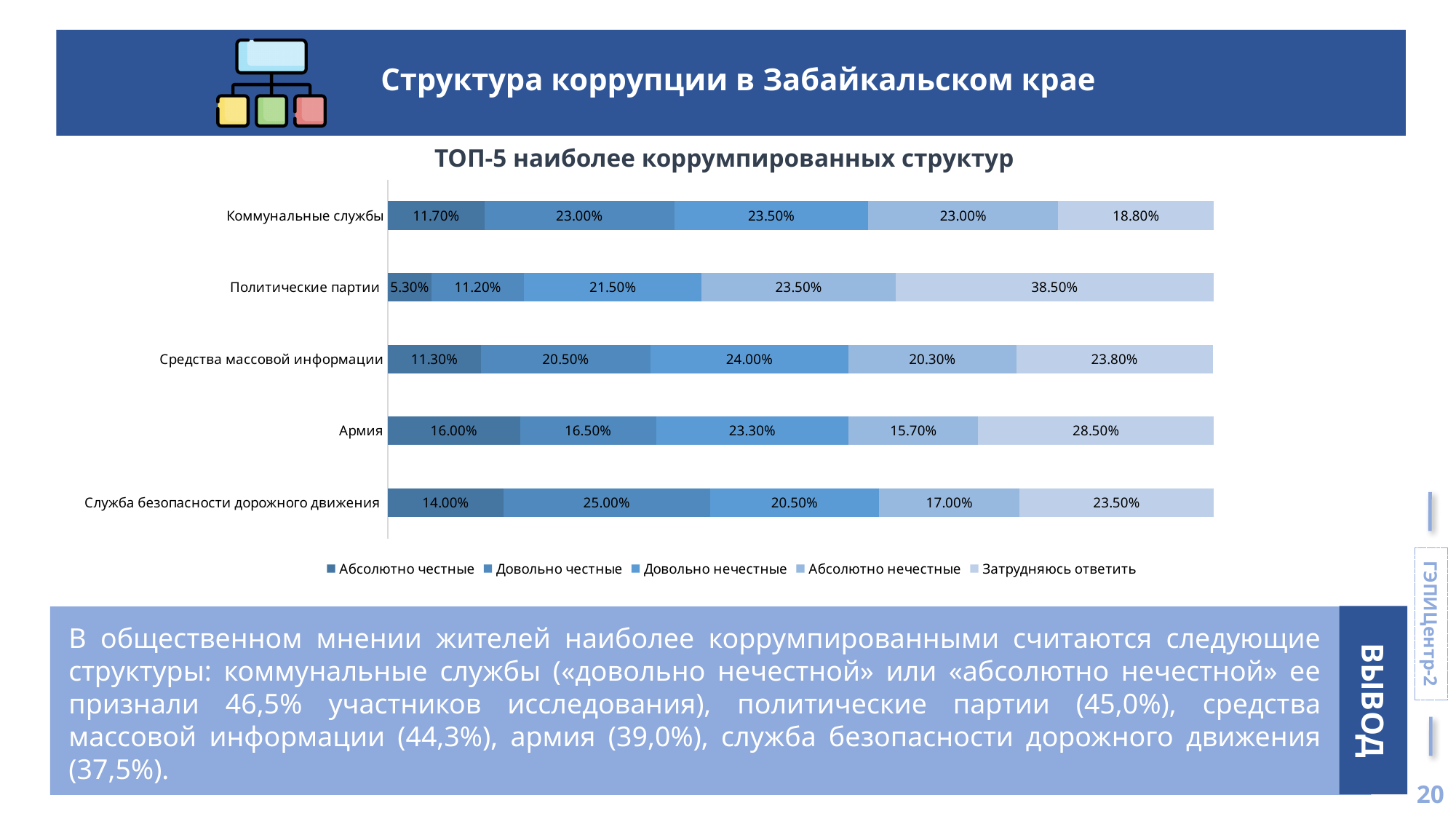
What is the value of «Абсолютно честные» for «Армия»? 16.00% Which category has the lowest value for «Абсолютно честные»? Политические партии How many series does the legend list? 5 What is the value of «Довольно нечестные» for «Средства массовой информации»? 24.00% Which has the larger «Абсолютно нечестные» value: «Политические партии» or «Армия»? Политические партии What is the difference between the «Довольно честные» values for «Служба безопасности дорожного движения» and «Армия»? 8.50% What is the title of the chart? ТОП-5 наиболее коррумпированных структур What is the total of the stacked bar for «Коммунальные службы»? 100.00% What is the value of «Затрудняюсь ответить» for «Политические партии»? 38.50% Which category has the highest value for «Затрудняюсь ответить»? Политические партии What kind of chart is shown on the slide? Stacked bar chart How many categories (structures) are shown in the chart? 5